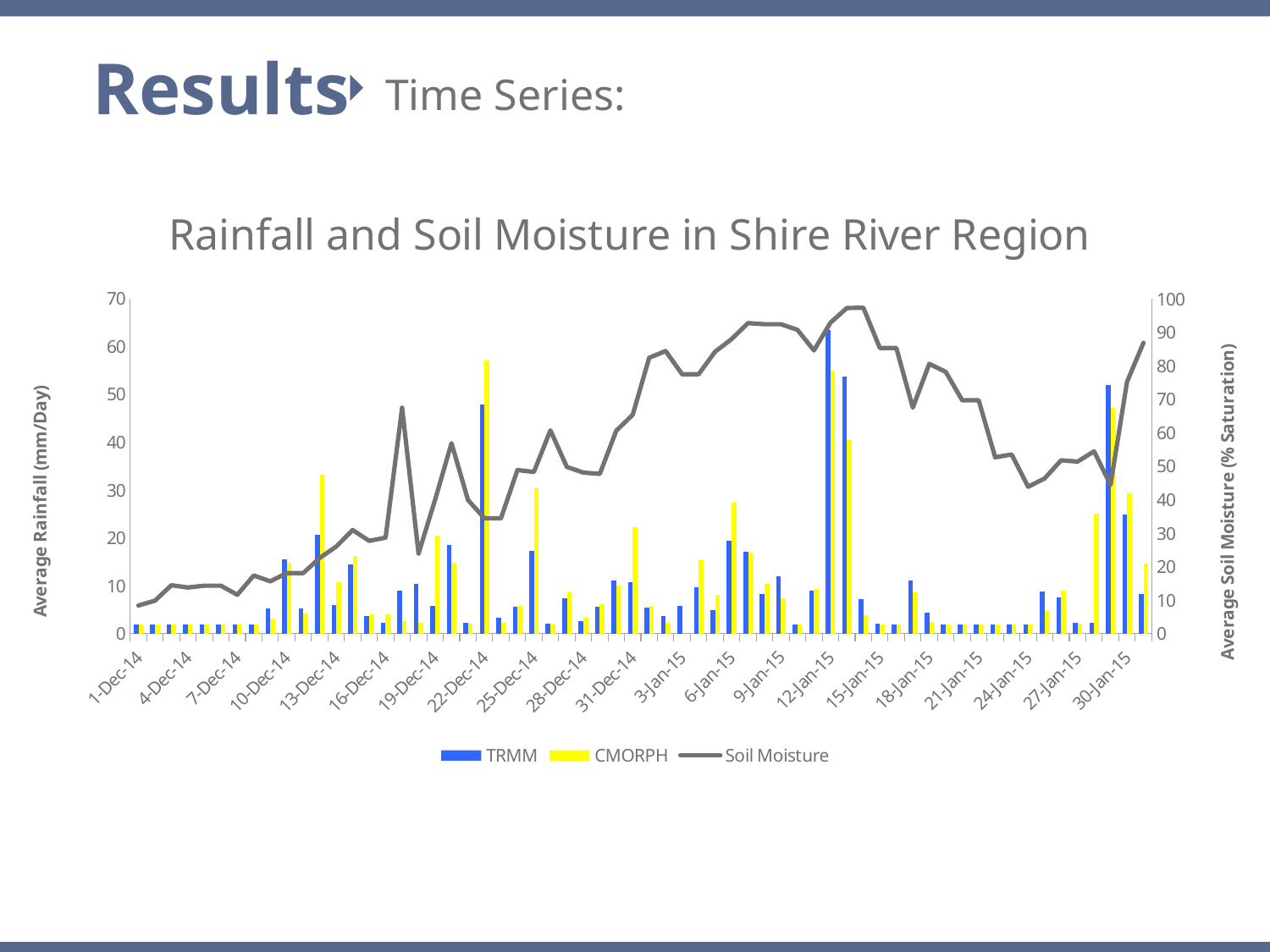
Is the peak Soil Moisture value in mid-January greater or less than 90? greater Which is larger, the CMORPH value on 22-Dec-14 or the CMORPH value on 4-Dec-14? 22-Dec-14 What is the title of the chart? Rainfall and Soil Moisture in Shire River Region What kind of chart is shown on the slide? A combination bar and line chart Is the Soil Moisture value on 1-Dec-14 greater or less than 20? less Which is larger, the TRMM value on 12-Jan-15 or the TRMM value on 1-Dec-14? 12-Jan-15 Is the TRMM value on 12-Jan-15 greater or less than 50? greater How many series does the legend list? 3 Does the Soil Moisture line generally rise or fall from 1-Dec-14 to 12-Jan-15? rise How many date labels are shown on the x axis? 21 On which date does the TRMM series reach its highest value? 12-Jan-15 Which series is drawn as a line rather than bars? Soil Moisture